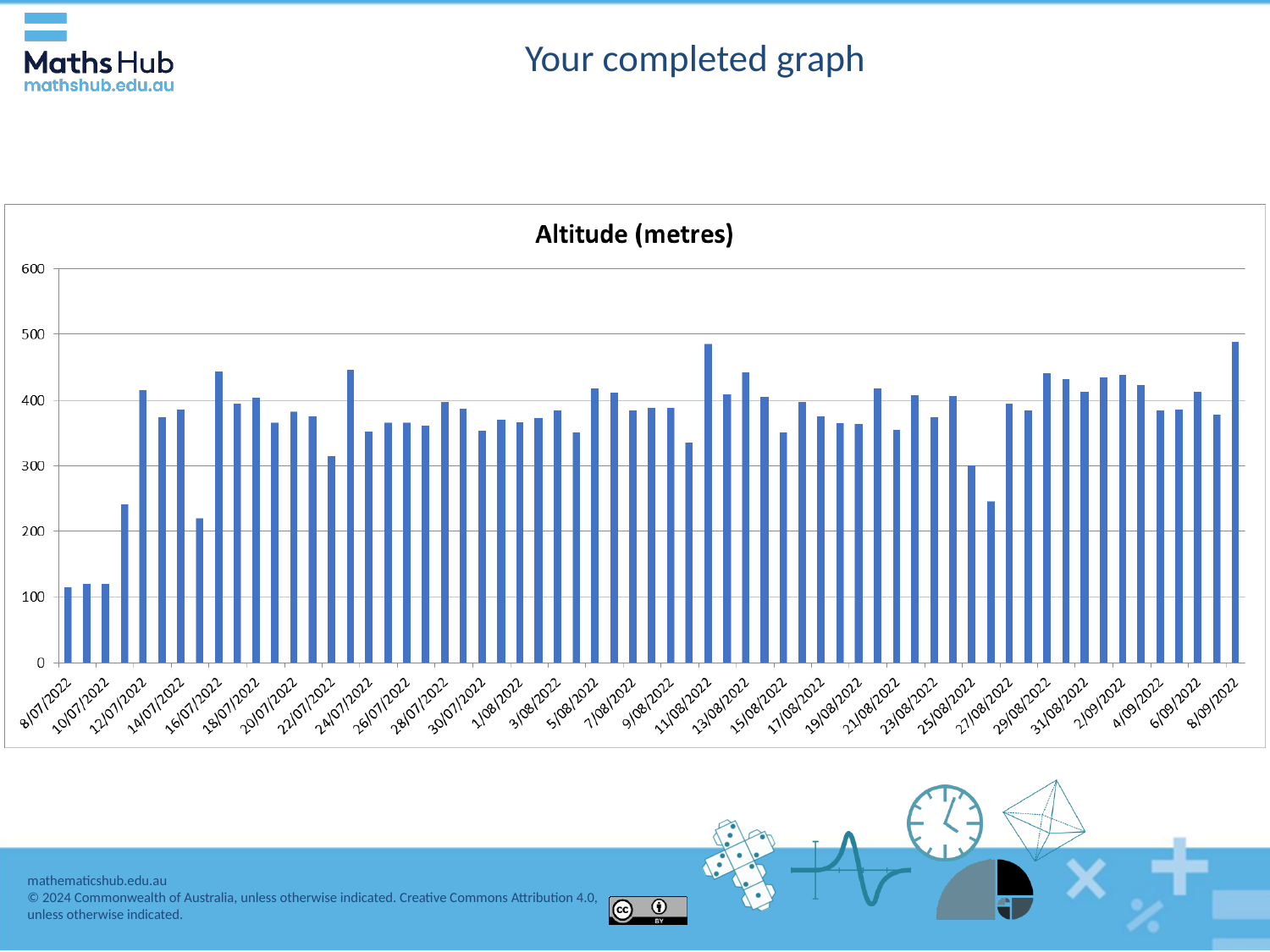
Is the value for 8/09/2022 greater or less than 400? greater What type of chart is shown on the slide? bar chart Which has the larger value, 8/07/2022 or 12/07/2022? 12/07/2022 Is the value for 16/07/2022 greater or less than 400? greater Which has the larger value, 10/07/2022 or 16/07/2022? 16/07/2022 Is the value for 8/07/2022 greater or less than 200? less Do the values rise or fall from 8/07/2022 to 12/07/2022? rise What is the highest value shown on the vertical axis of the chart? 600 What is the title of the chart? Altitude (metres)